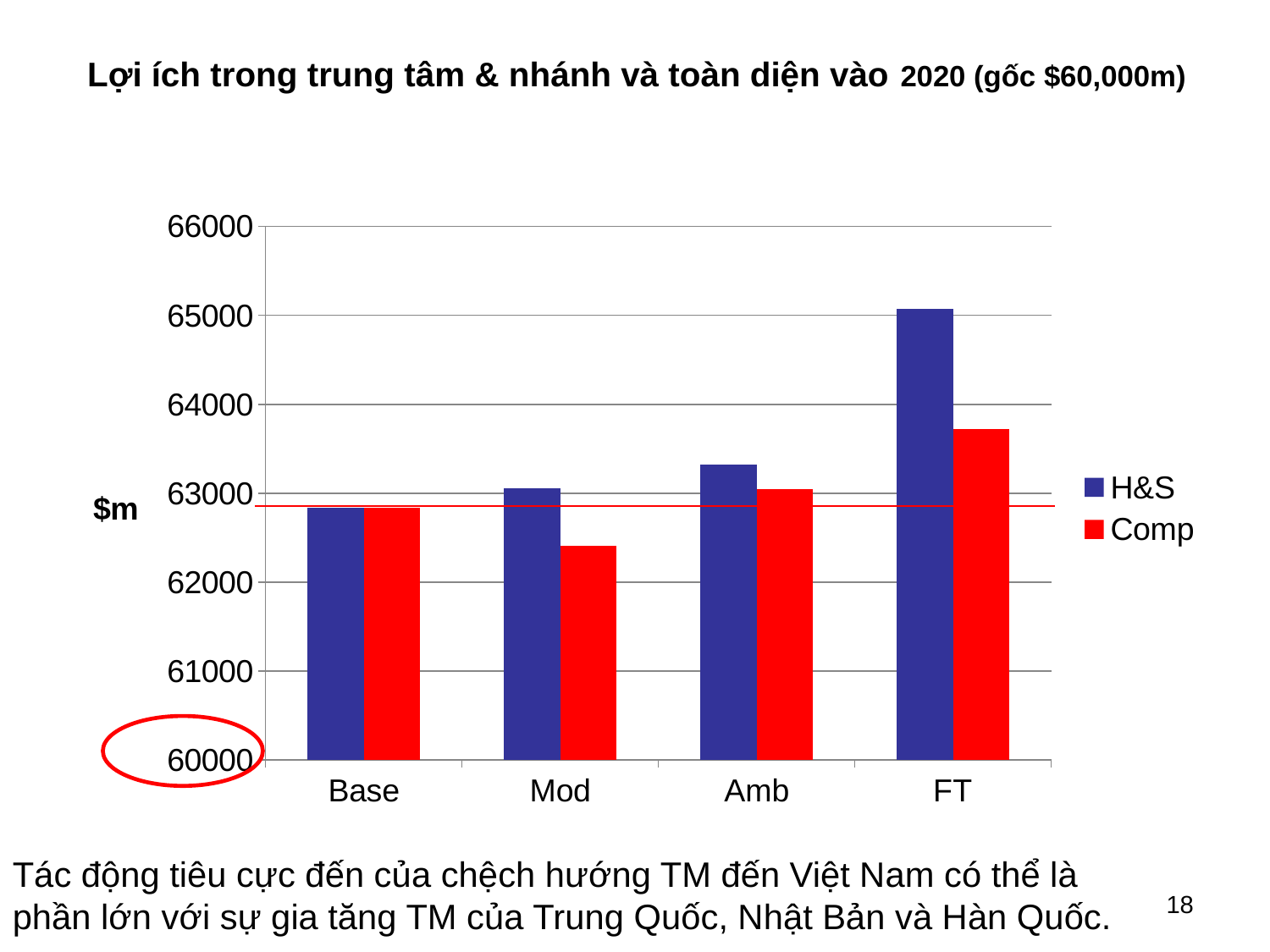
For Mod, which is larger: H&S or Comp? H&S For FT, which is larger: H&S or Comp? H&S Is the Comp value for Mod greater or less than 63000? less What kind of chart is shown on the slide? bar chart Which category has the lowest Comp value? Mod How many series does the legend list? 2 Do the H&S values rise or fall from Base to FT? rise Is the H&S value for FT greater or less than 64000? greater Is the Comp value for FT greater or less than 64000? less What colour represents the Comp series in the legend? red Which category has the highest H&S value? FT How many categories are shown on the x axis? 4